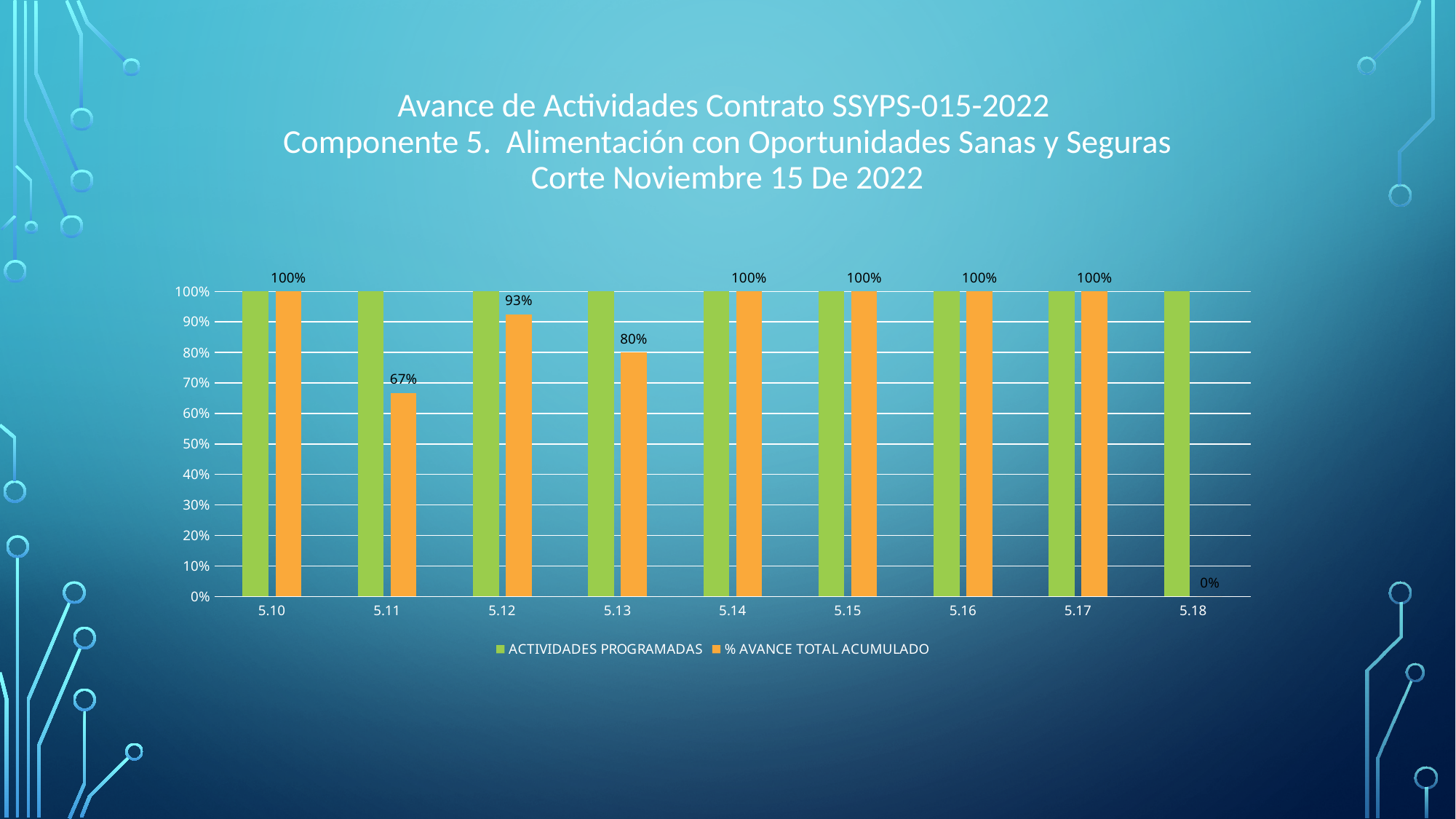
What is the % AVANCE TOTAL ACUMULADO value for category 5.12? 93% How many series does the chart legend list? 2 What is the % AVANCE TOTAL ACUMULADO value for category 5.13? 80% Is the % AVANCE TOTAL ACUMULADO value for 5.11 greater or less than 70%? less What is the % AVANCE TOTAL ACUMULADO value for category 5.18? 0% What is the % AVANCE TOTAL ACUMULADO value for category 5.11? 67% How many categories are shown on the x axis of the chart? 9 What kind of chart is shown on the slide? Bar chart What is the difference between the % AVANCE TOTAL ACUMULADO values for 5.12 and 5.11? 26% Which has a larger % AVANCE TOTAL ACUMULADO value, 5.13 or 5.11? 5.13 Which category has the lowest % AVANCE TOTAL ACUMULADO value? 5.18 Which colour represents the ACTIVIDADES PROGRAMADAS series in the chart? Green